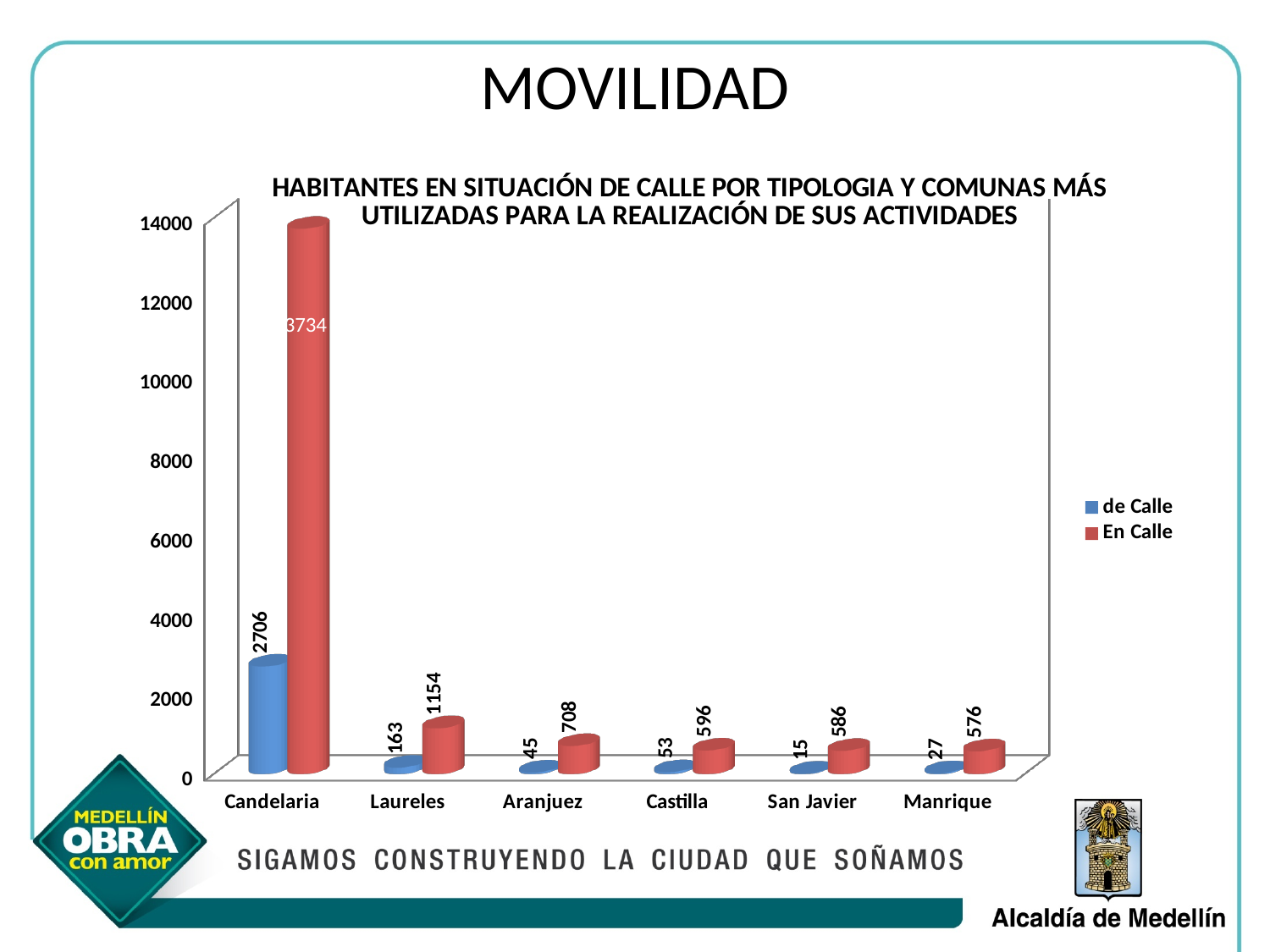
What is the 'En Calle' value for Manrique? 576 How many comunas are shown on the x axis of the chart? 6 How many series does the legend list? 2 What kind of chart is shown on the slide? bar chart For Laureles, what is the difference between the 'En Calle' value and the 'de Calle' value? 991 Which comuna has the highest 'En Calle' value? Candelaria What is the 'de Calle' value for San Javier? 15 Which comuna has the lowest 'de Calle' value? San Javier What is the 'En Calle' value for Laureles? 1154 Which is larger, the 'de Calle' value for Aranjuez or the 'de Calle' value for Castilla? Castilla What is the 'de Calle' value for Candelaria? 2706 Is the 'En Calle' value for Candelaria greater or less than 12000? greater